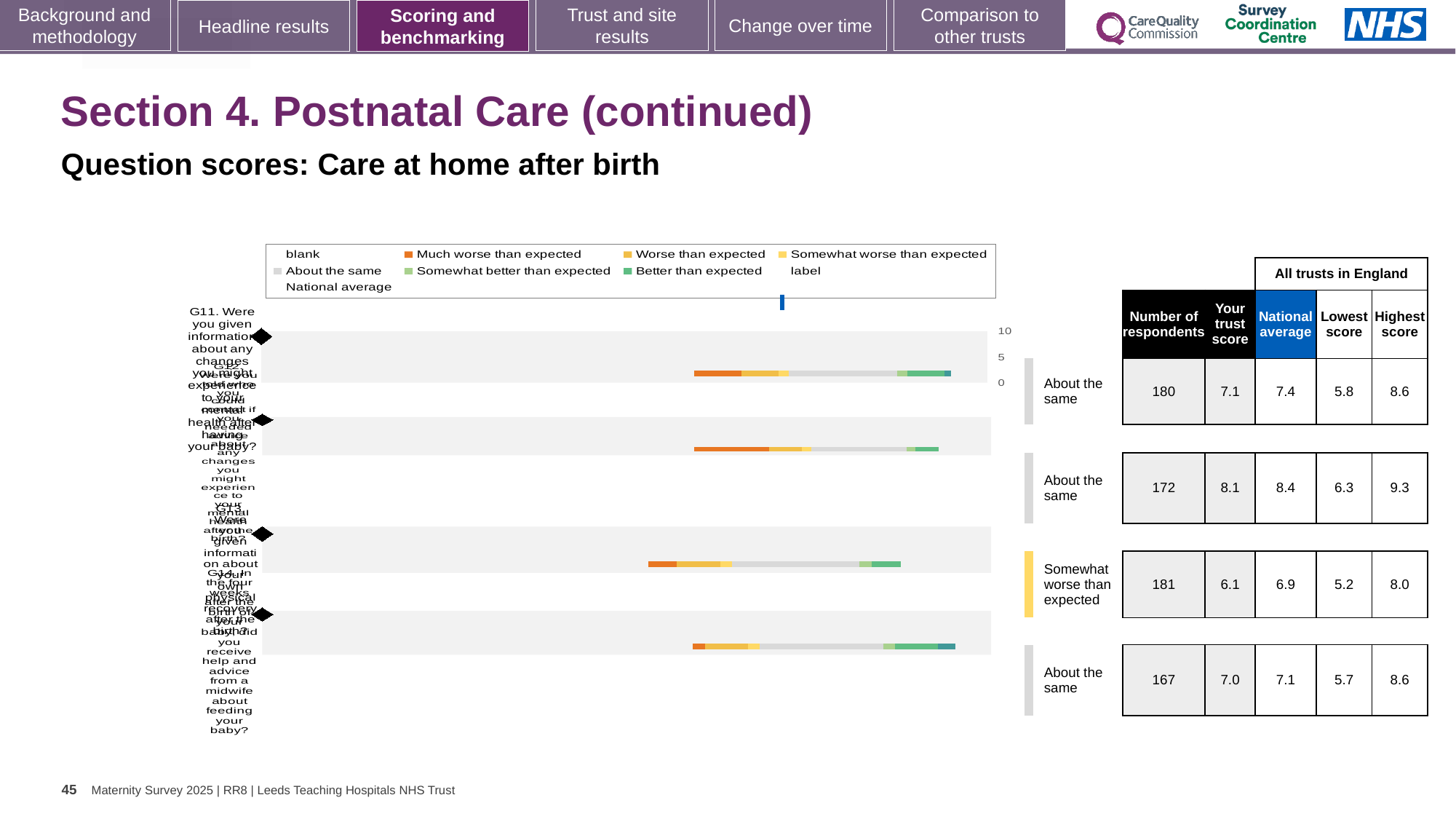
What is the national average for the second row of the chart? 8.4 What is the number of respondents for the first row (G11, information about changes to your mental health after having your baby)? 180 What is the trust score for the first row (G11)? 7.1 For the fourth row, which is larger: the trust score or the national average? the national average (7.1) What is the lowest score across all trusts in England for the third row of the chart? 5.2 What is the difference between the national average and the trust score for the first row (G11)? 0.3 Which row has the highest number of respondents? the third row (181) What is the highest score across all trusts in England for the second row of the chart? 9.3 What benchmark category is shown for the third row of the chart? Somewhat worse than expected How many question rows are plotted in the chart? 4 Which row has the lowest trust score? the third row (6.1) What kind of chart is shown on the slide? bar chart